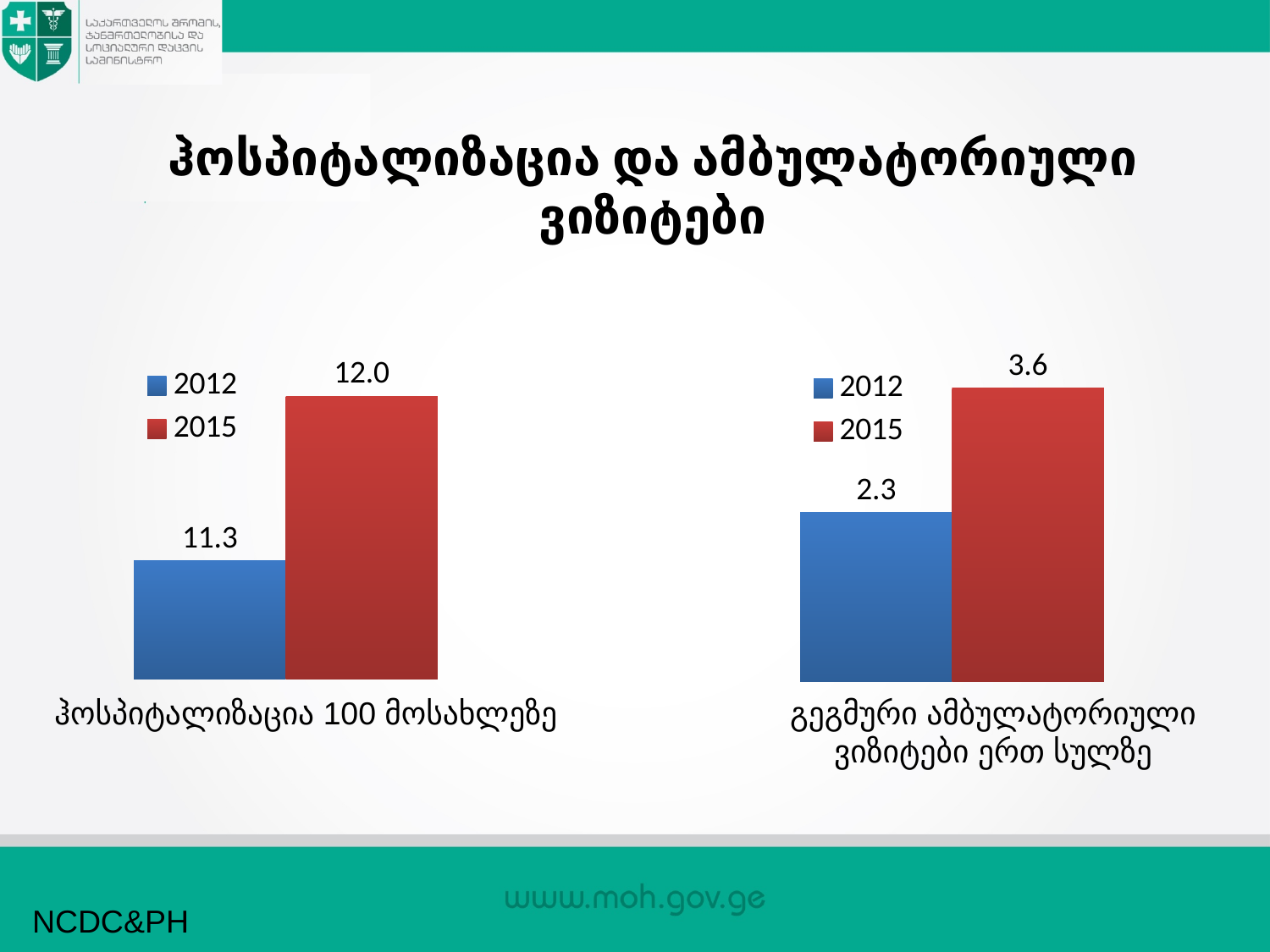
In the left chart (ჰოსპიტალიზაცია 100 მოსახლეზე), what is the value for 2012? 11.3 What type of chart is the left chart? Bar chart How many series does the legend of the right chart list? 2 In the right chart, do the values rise or fall from 2012 to 2015? Rise In the left chart, which colour represents 2015? Red In the left chart (ჰოსპიტალიზაცია 100 მოსახლეზე), what is the value for 2015? 12.0 In the left chart, which year has the higher value, 2012 or 2015? 2015 In the right chart, which year has the lower value? 2012 In the right chart (გეგმური ამბულატორიული ვიზიტები ერთ სულზე), what is the value for 2012? 2.3 In the right chart (გეგმური ამბულატორიული ვიზიტები ერთ სულზე), what is the value for 2015? 3.6 In the left chart, what is the difference between the 2015 and 2012 values? 0.7 In the right chart, what is the difference between the 2015 and 2012 values? 1.3